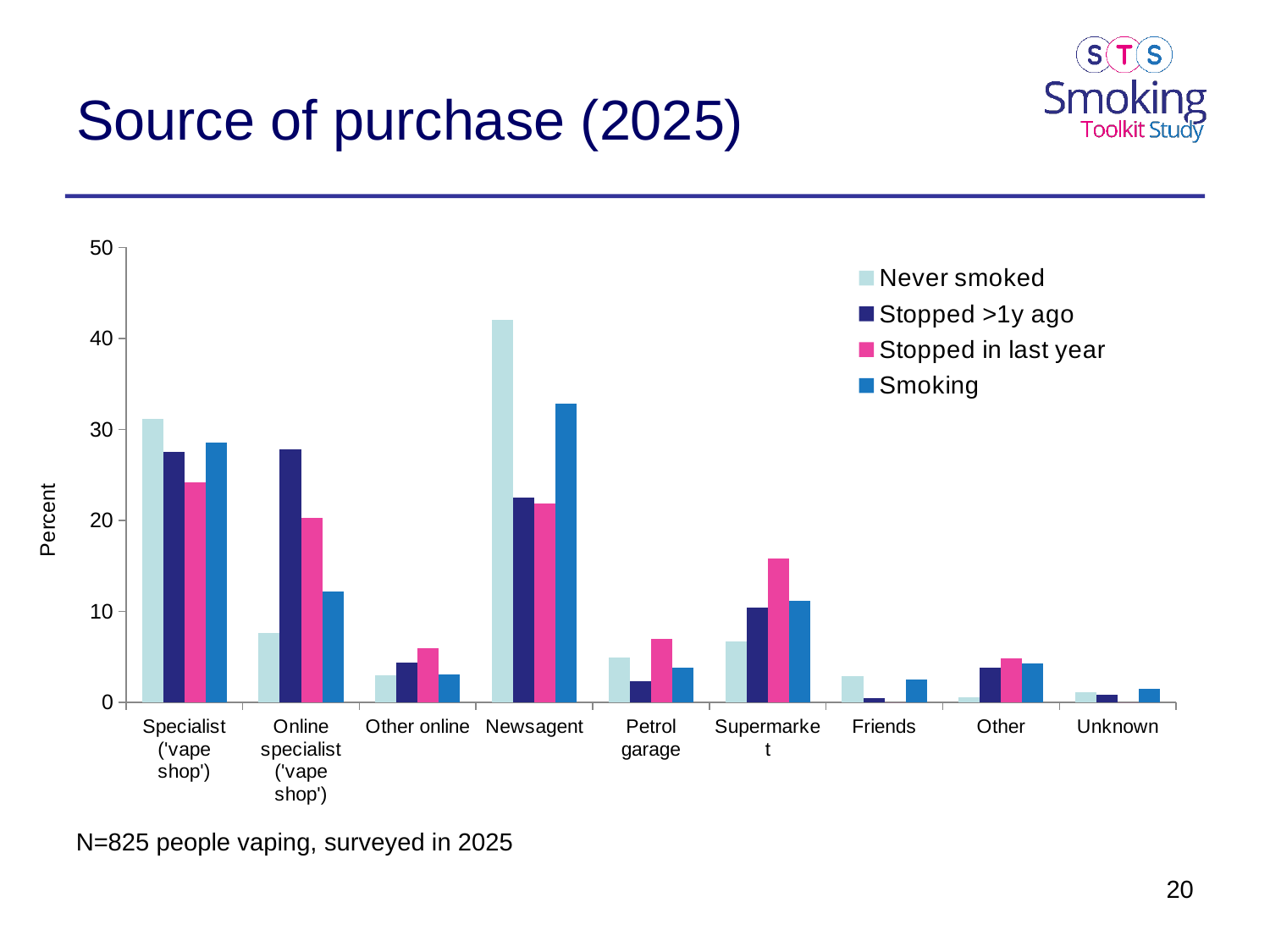
What is the label on the y axis? Percent What kind of chart is shown on the slide? bar chart For the Never smoked series, which category has the highest value? Newsagent Is the Never smoked value for Online specialist ('vape shop') greater or less than 10? less How many purchase source categories are shown on the x axis? 9 How many series does the legend list? 4 What is the title of the chart? Source of purchase (2025) For Specialist ('vape shop'), which is larger: Never smoked or Stopped in last year? Never smoked For Online specialist ('vape shop'), which is larger: Stopped >1y ago or Smoking? Stopped >1y ago Is the Never smoked value for Newsagent greater or less than 40? greater Is the Smoking value for Newsagent greater or less than 30? greater For Supermarket, which series has the highest value? Stopped in last year